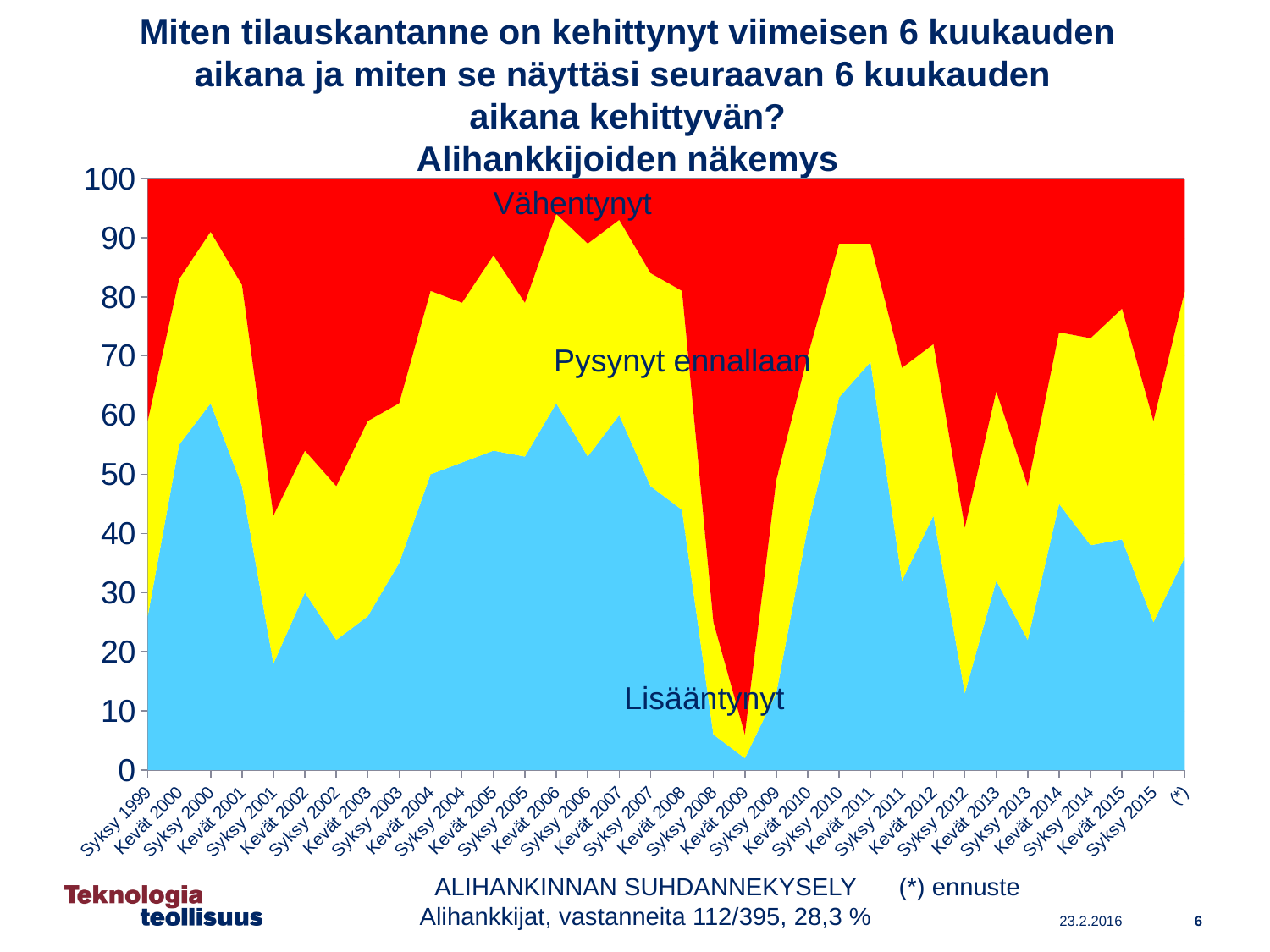
Which has a larger Lisääntynyt value, Kevät 2011 or Syksy 2012? Kevät 2011 Does the Lisääntynyt share rise or fall from Syksy 2008 to Kevät 2009? fall How many series are shown in the chart? 3 Which series is drawn in red at the top of the chart? Vähentynyt Which series is drawn in light blue at the bottom of the chart? Lisääntynyt At which time point is the Lisääntynyt share highest? Kevät 2011 Is the Lisääntynyt value for Syksy 2012 greater or less than 20? less What kind of chart is shown on the slide? Stacked area chart How many time points are shown along the x axis of the chart? 34 Is the Lisääntynyt value for Kevät 2011 greater or less than 60? greater At which time point is the Lisääntynyt share lowest? Kevät 2009 Is the Lisääntynyt value for Kevät 2009 greater or less than 10? less